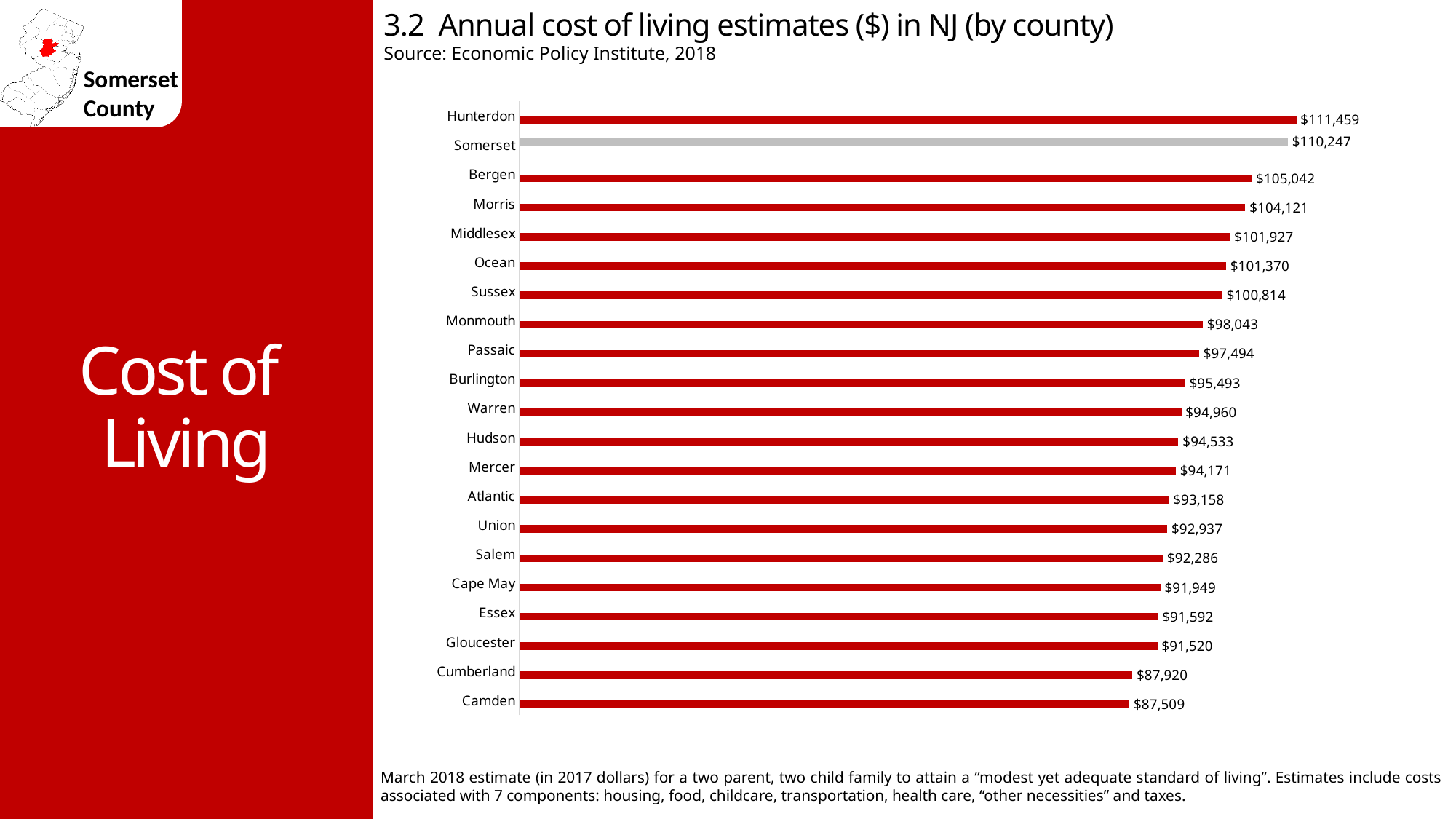
What is the annual cost of living estimate for Middlesex county? $101,927 How many counties are shown in the chart? 21 What is the difference between the cost of living estimates for Hunterdon and Camden? $23,950 Which county has a higher cost of living estimate, Bergen or Monmouth? Bergen Which county has the lowest annual cost of living estimate? Camden What is the annual cost of living estimate for Cape May county? $91,949 Which county has the highest annual cost of living estimate? Hunterdon What type of chart is used to show the cost of living estimates? Bar chart What is the difference between the cost of living estimates for Hunterdon and Somerset? $1,212 Which county has a higher cost of living estimate, Cumberland or Gloucester? Gloucester Which county's bar is shown in grey rather than red? Somerset What is the annual cost of living estimate for Somerset county? $110,247